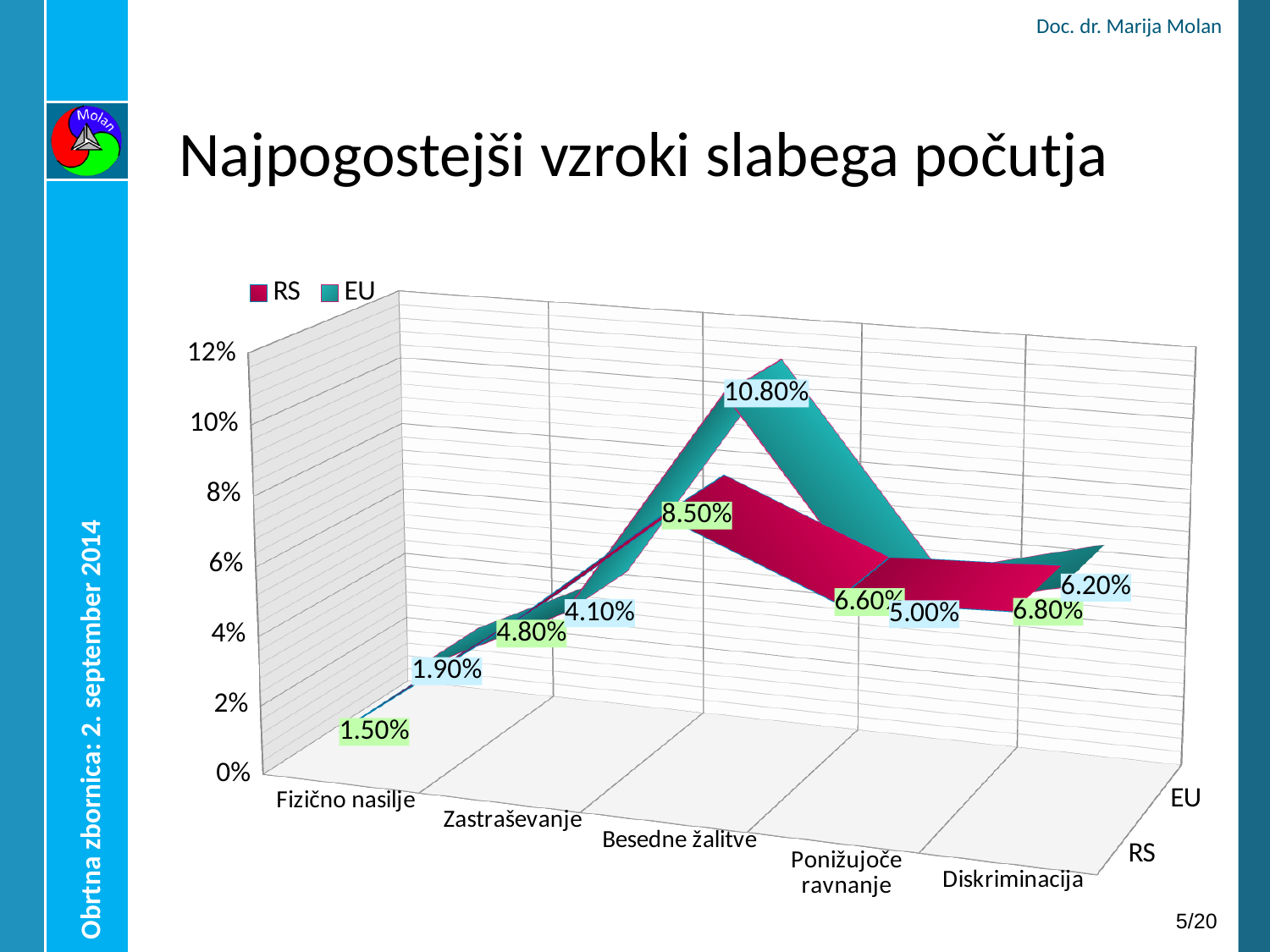
What is the EU value for Diskriminacija? 6.20% What is the EU value for Besedne žalitve? 10.80% How many series does the legend list? 2 What is the title of the slide containing the chart? Najpogostejši vzroki slabega počutja How many categories are shown on the x axis? 5 What is the RS value for Besedne žalitve? 8.50% What is the difference between the EU and RS values for Besedne žalitve? 2.30% Which category has the highest EU value? Besedne žalitve What is the RS value for Fizično nasilje? 1.50% What kind of chart is shown on the slide? 3D line chart For Ponižujoče ravnanje, which series has the larger value, RS or EU? RS Which category has the lowest RS value? Fizično nasilje